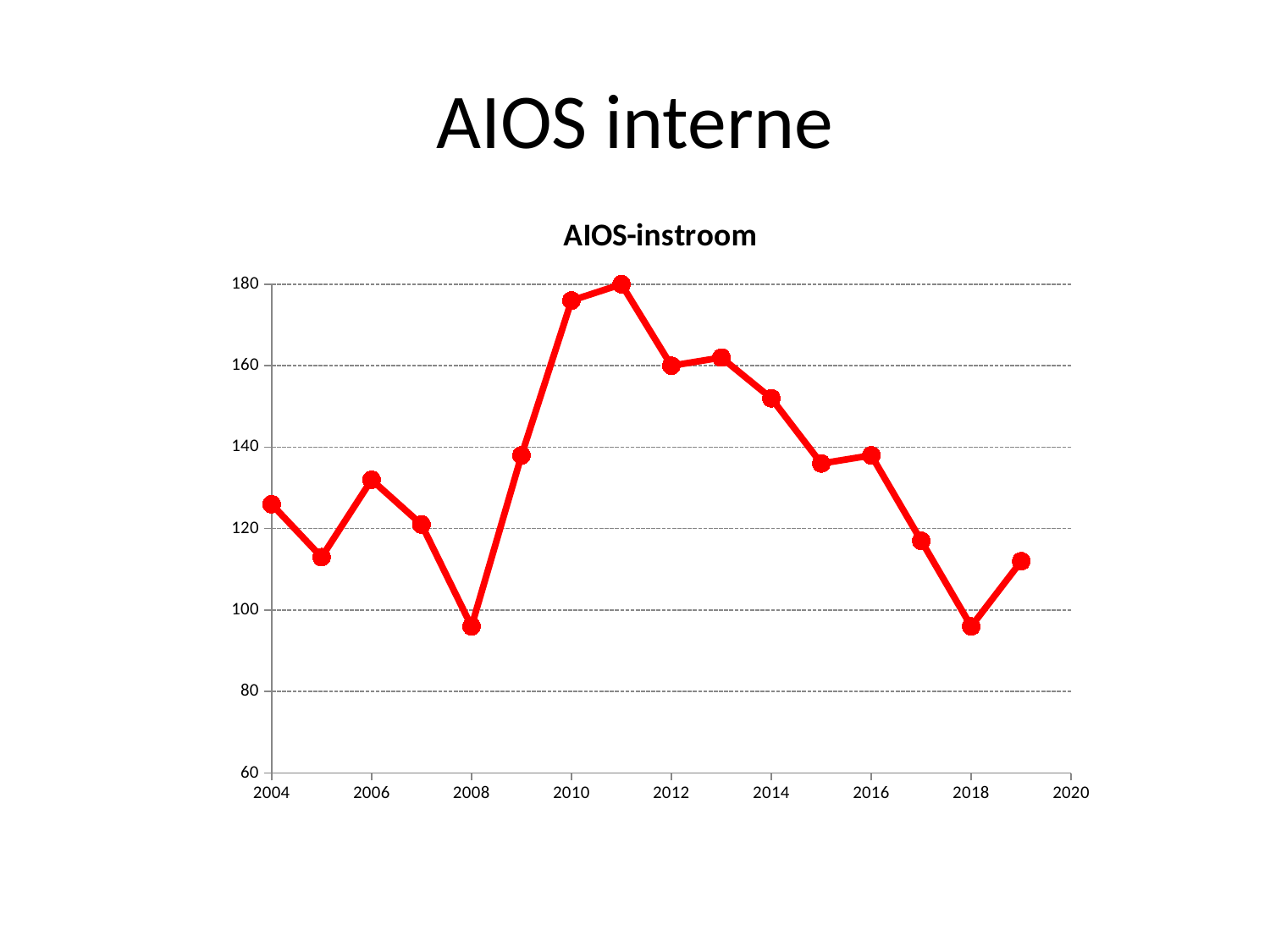
Is the value for 2010 greater or less than 160? greater What kind of chart is shown on the slide? line chart What is the title of the chart? AIOS-instroom Do the values rise or fall from 2011 to 2018? fall Is the value for 2017 greater or less than 120? less What colour is the plotted line? red How many data points are plotted on the line? 16 What is the value for 2011? 180 Is the value for 2014 greater or less than 140? greater In which year does the AIOS-instroom line reach its highest value? 2011 Which year has the larger value, 2010 or 2015? 2010